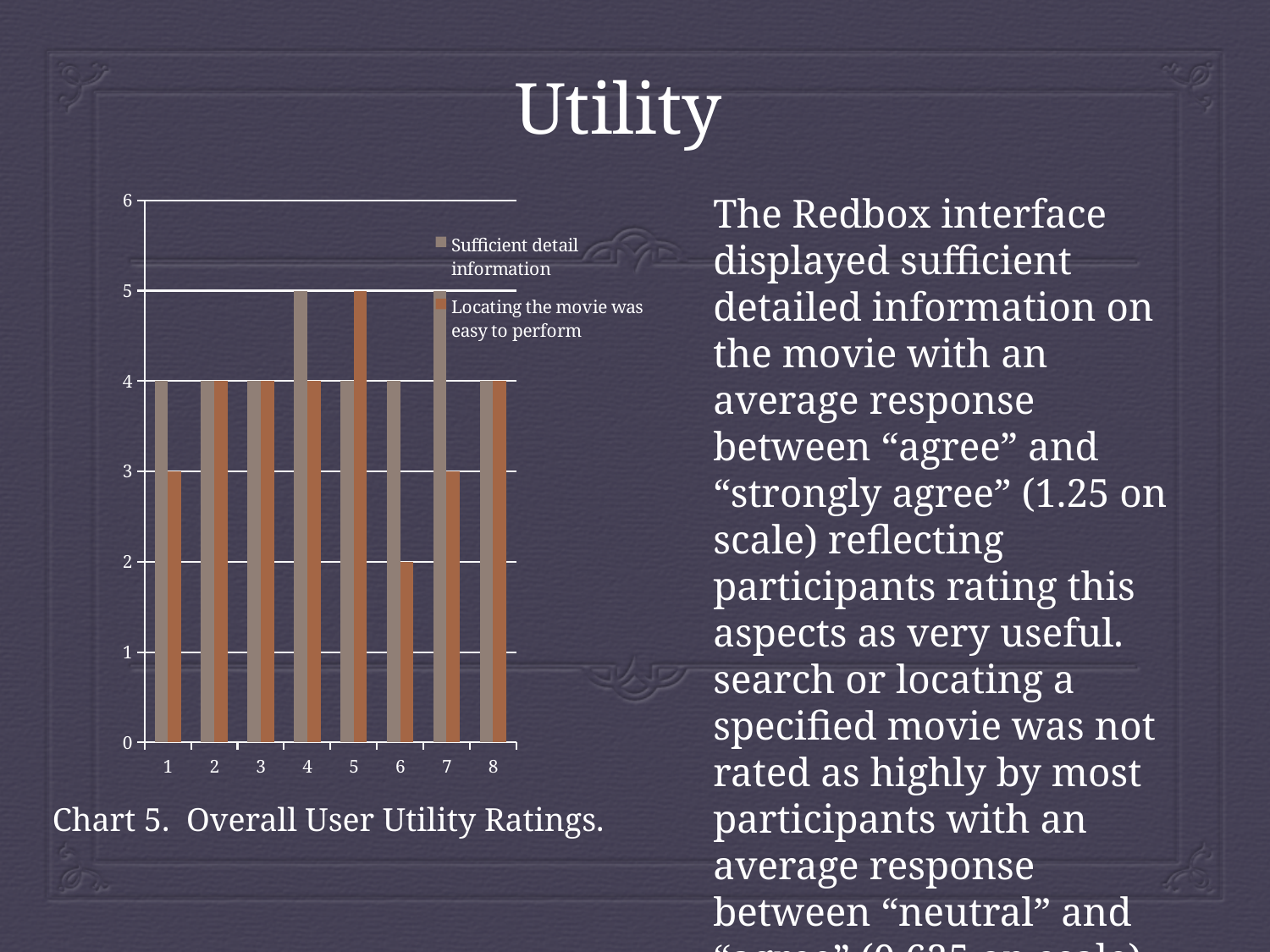
For participant 5, which series has the larger value: 'Sufficient detail information' or 'Locating the movie was easy to perform'? Locating the movie was easy to perform What is the value of 'Sufficient detail information' for participant 7? 5 What is the value of 'Locating the movie was easy to perform' for participant 1? 3 How many series does the chart legend list? 2 How many categories are shown on the x axis of the chart? 8 What is the value of 'Sufficient detail information' for participant 4? 5 What is the caption given below the chart? Chart 5. Overall User Utility Ratings. What is the difference between 'Sufficient detail information' and 'Locating the movie was easy to perform' for participant 6? 2 What is the value of 'Locating the movie was easy to perform' for participant 6? 2 Which participant has the lowest value for 'Locating the movie was easy to perform'? 6 What kind of chart is shown on the slide? bar chart What is the maximum value shown on the chart's vertical axis? 6